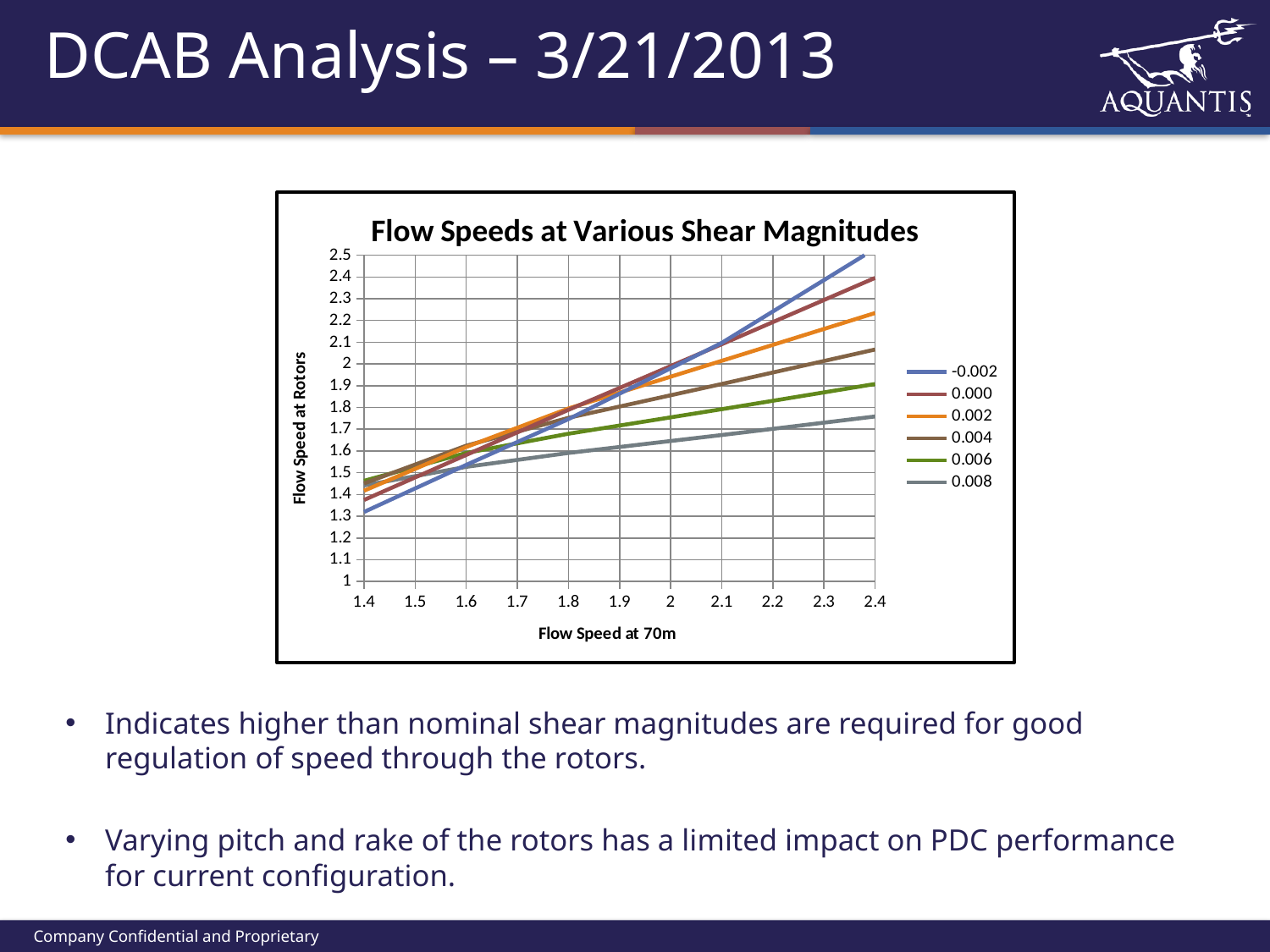
Which series has the lowest Flow Speed at Rotors at a Flow Speed at 70m of 2.4? 0.008 Is the value for the 0.008 series at a Flow Speed at 70m of 2.4 greater or less than 1.8? less What kind of chart is shown on the slide? line chart At a Flow Speed at 70m of 1.4, which series has the larger value: 0.008 or -0.002? 0.008 How many series does the legend list? 6 Is the value for the 0.000 series at a Flow Speed at 70m of 2.4 greater or less than 2.3? greater What is the title of the chart? Flow Speeds at Various Shear Magnitudes At a Flow Speed at 70m of 2.4, which series has the larger value: 0.002 or 0.006? 0.002 Is the value for the -0.002 series at a Flow Speed at 70m of 1.4 greater or less than 1.4? less Which series has the highest Flow Speed at Rotors at a Flow Speed at 70m of 2.4? -0.002 Do the values of the -0.002 series rise or fall as Flow Speed at 70m increases? rise What is the label of the x axis? Flow Speed at 70m